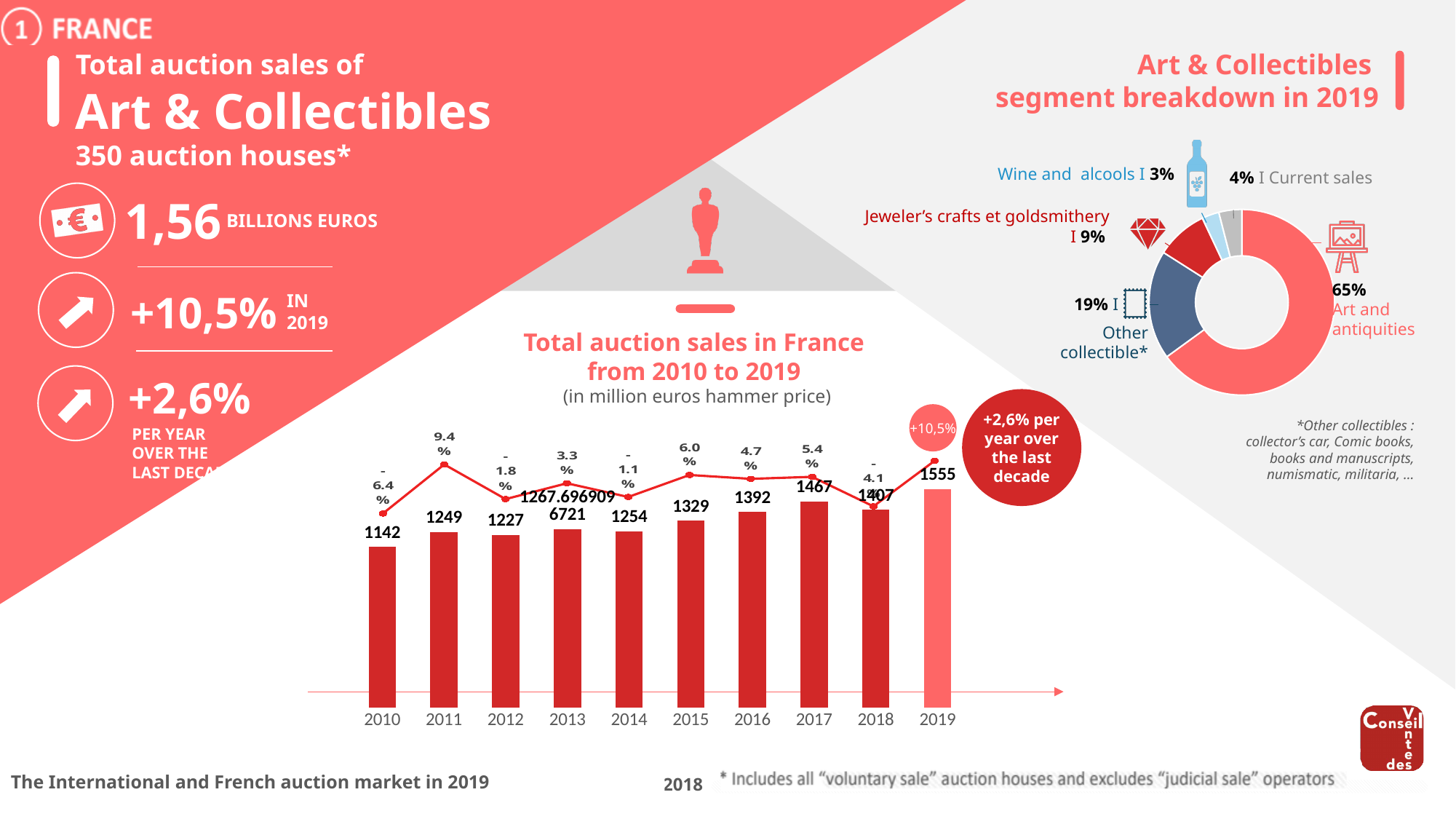
In the chart 'Total auction sales in France from 2010 to 2019', what is the difference between the 2017 and 2016 values? 75 In the chart 'Total auction sales in France from 2010 to 2019', what is the value for 2019? 1555 What kind of chart is 'Total auction sales in France from 2010 to 2019'? Bar chart In the 'Art & Collectibles segment breakdown in 2019' chart, which segment has the largest share? Art and antiquities In the chart 'Total auction sales in France from 2010 to 2019', which year has the highest sales? 2019 In the chart 'Total auction sales in France from 2010 to 2019', which year has the larger value, 2014 or 2015? 2015 How many years are shown on the x axis of the chart 'Total auction sales in France from 2010 to 2019'? 10 In the chart 'Total auction sales in France from 2010 to 2019', what percentage change is shown for 2011? 9.4% In the chart 'Total auction sales in France from 2010 to 2019', what is the value for 2010? 1142 In the 'Art & Collectibles segment breakdown in 2019' chart, what is the share of Other collectible*? 19% In the chart 'Total auction sales in France from 2010 to 2019', which year has the lowest sales? 2010 In the 'Art & Collectibles segment breakdown in 2019' chart, which segment has the smallest share? Wine and alcools